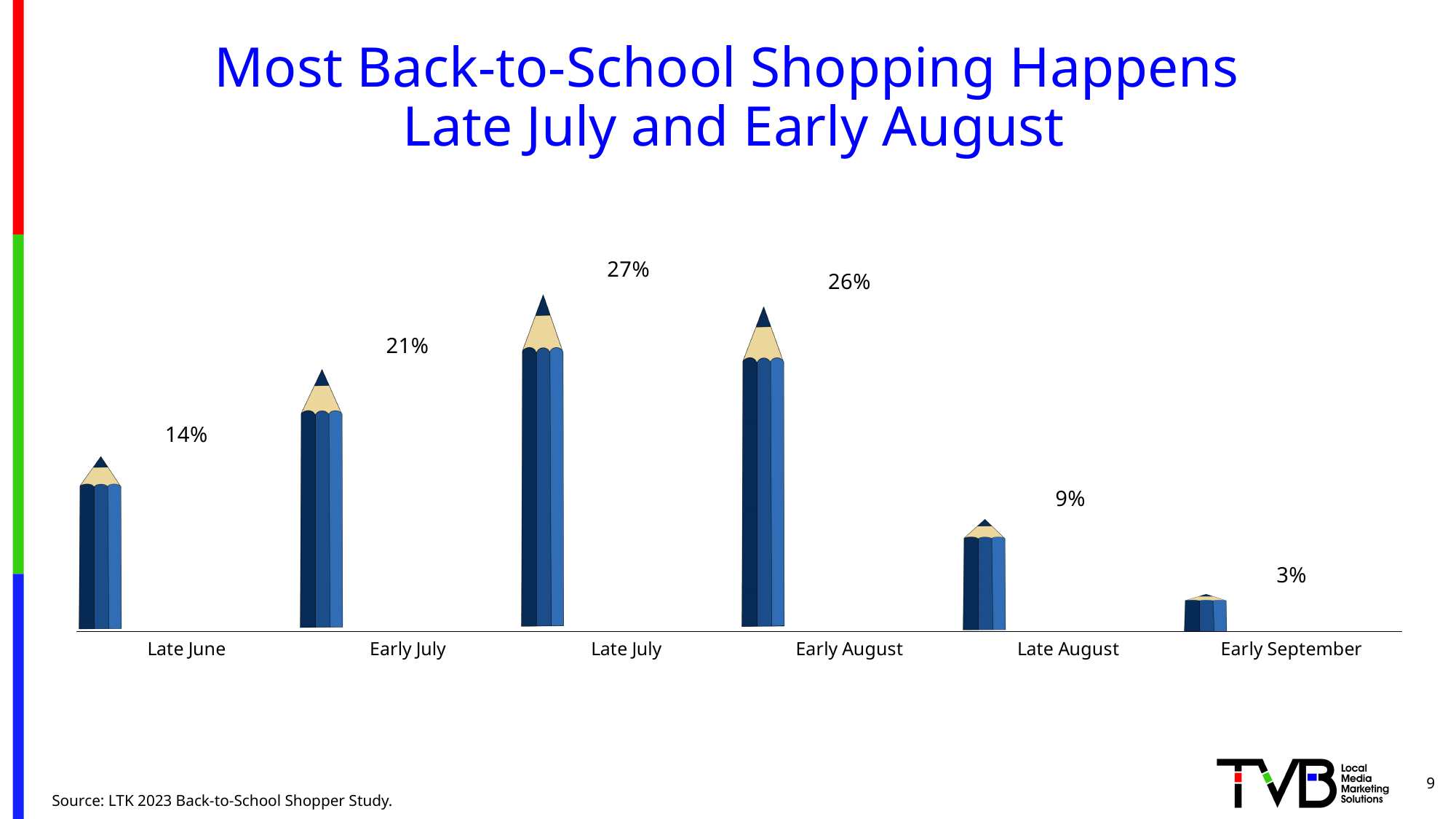
Which is larger, the value for Early July or the value for Late August? Early July What is the value for Late July? 27% What is the difference between the values for Late July and Early August? 1% How many periods are shown on the x axis? 6 Do the values rise or fall from Early August to Early September? fall Which period has the lowest value? Early September Which period has the highest value? Late July What kind of chart is shown on the slide? bar chart What is the value for Early September? 3% What is the value for Late June? 14% What is the title of the chart on the slide? Most Back-to-School Shopping Happens Late July and Early August What is the difference between the values for Early July and Late August? 12%